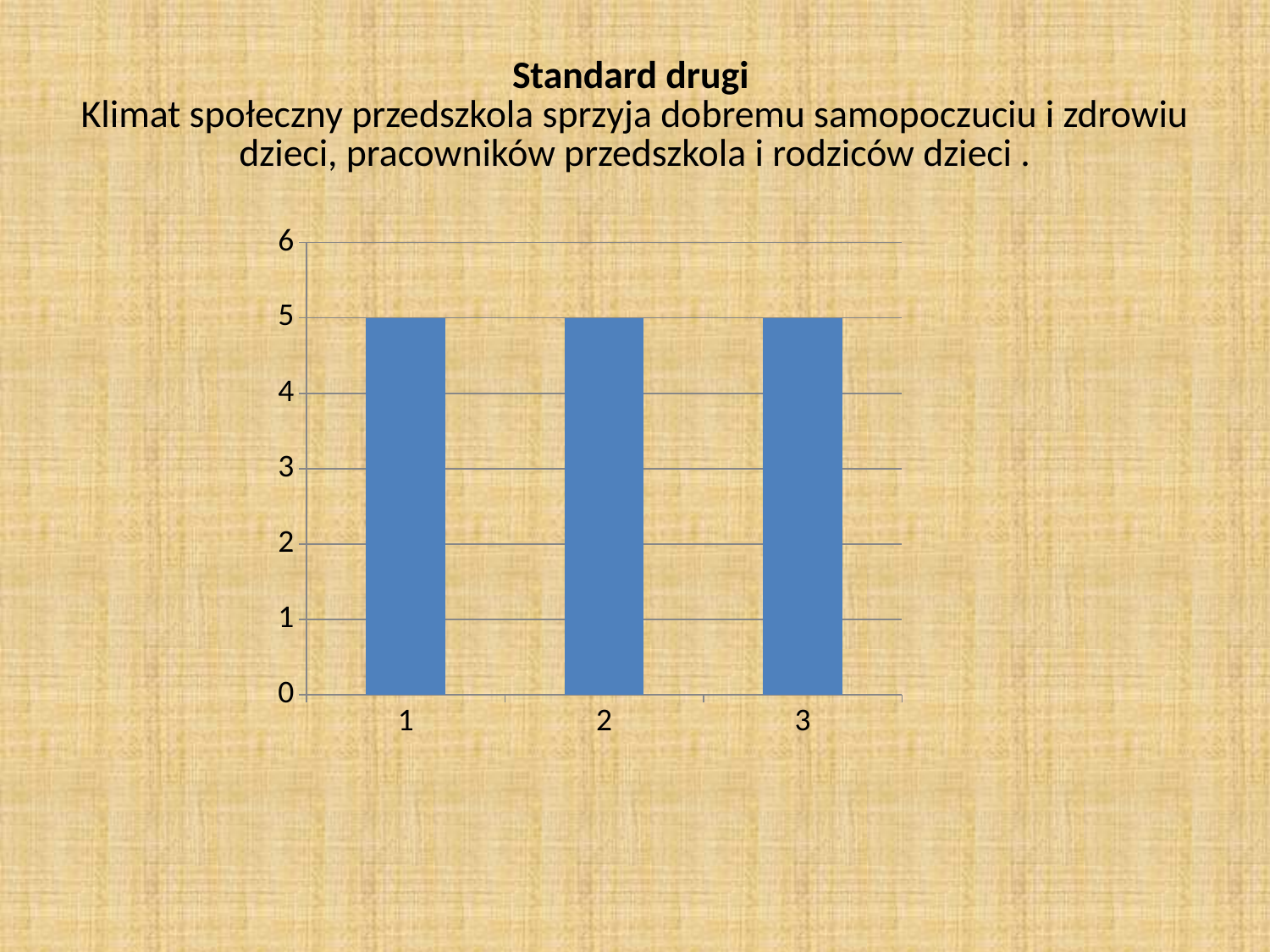
What is the difference between the values for category 1 and category 3? 0 Is the value for category 3 greater or less than 6? less What is the value for category 3? 5 Is the value for category 2 greater or less than 3? greater How many bars are shown in the chart? 3 What colour are the bars in the chart? blue Do the values rise, fall, or stay the same from category 1 to category 3? stay the same What is the highest value shown on the vertical axis? 6 What kind of chart is shown on the slide? bar chart What is the value for category 1? 5 Is the value for category 1 greater or less than 4? greater What is the value for category 2? 5